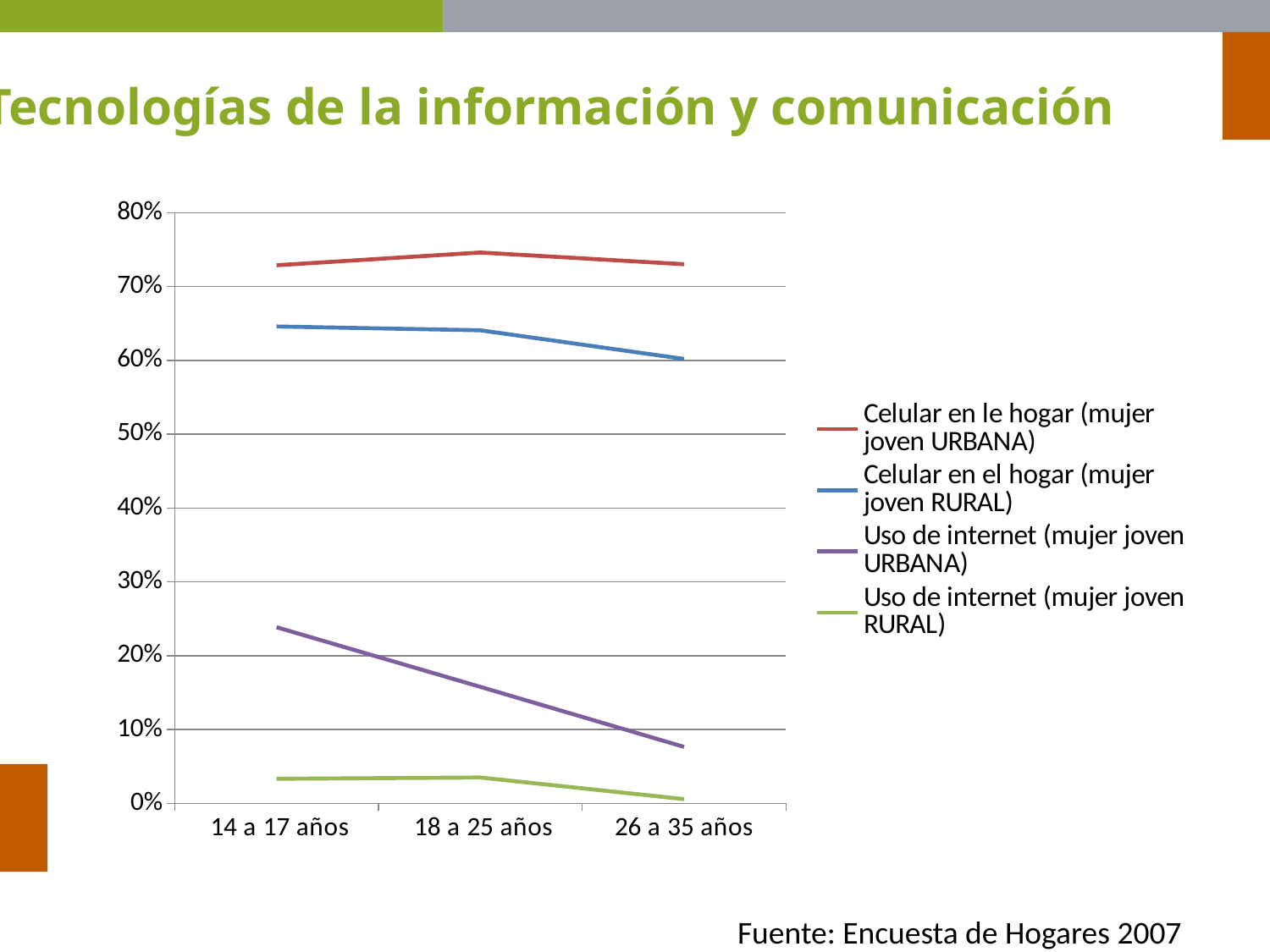
Is the value for Uso de internet (mujer joven RURAL) at 26 a 35 años greater or less than 10%? less At 14 a 17 años, which is larger: Celular en le hogar (mujer joven URBANA) or Celular en el hogar (mujer joven RURAL)? Celular en le hogar (mujer joven URBANA) Does the line for Uso de internet (mujer joven URBANA) rise or fall from 14 a 17 años to 26 a 35 años? Fall Is the value for Celular en el hogar (mujer joven RURAL) at 26 a 35 años greater or less than 70%? less What source is cited below the chart? Fuente: Encuesta de Hogares 2007 What kind of chart is shown on the slide? Line chart How many series does the legend list? 4 Is the value for Celular en le hogar (mujer joven URBANA) at 18 a 25 años greater or less than 70%? greater How many age groups are shown on the x axis? 3 Which series has the highest value at 26 a 35 años? Celular en le hogar (mujer joven URBANA) Which series has the lowest value at 14 a 17 años? Uso de internet (mujer joven RURAL)